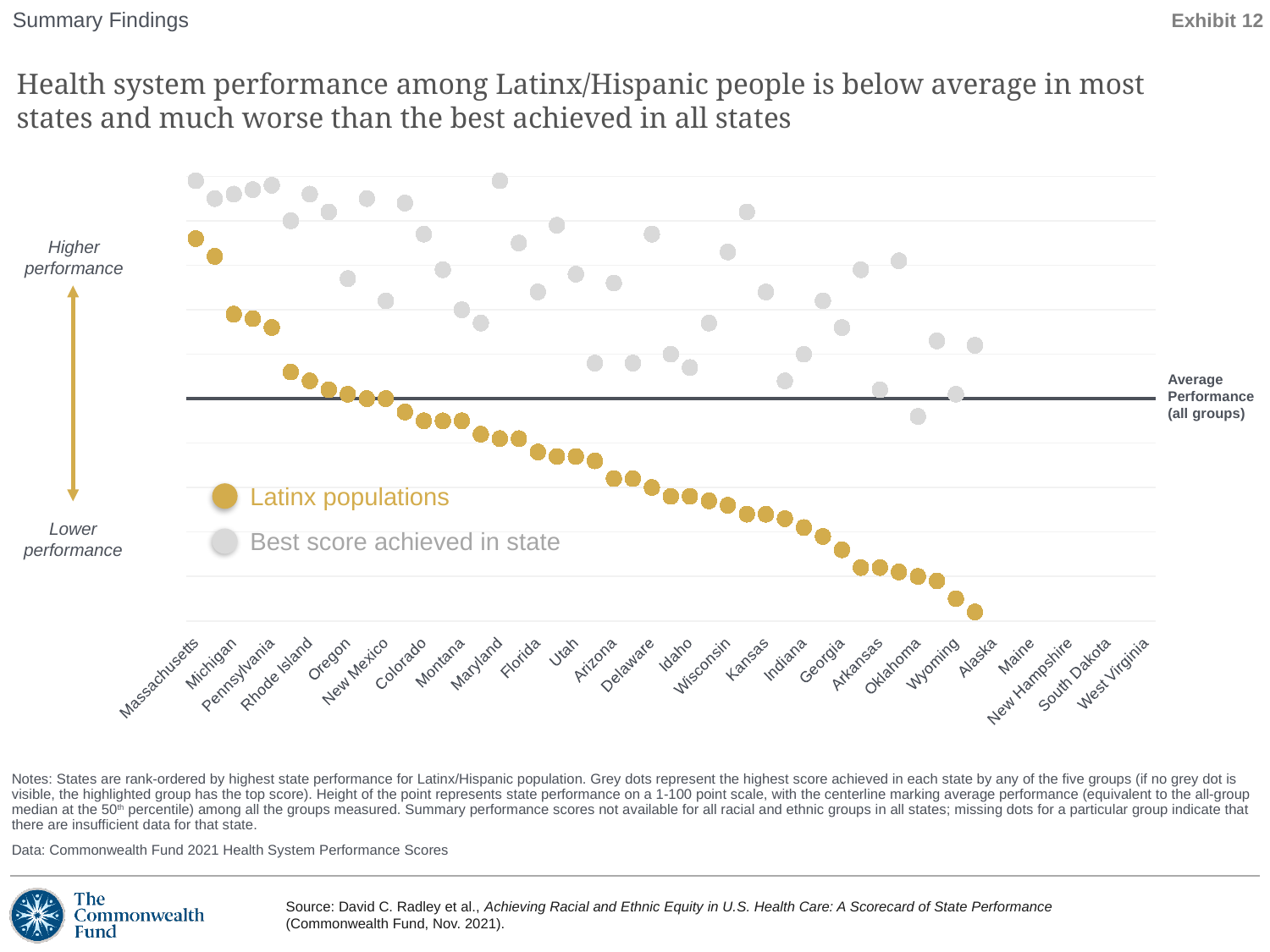
Which state has the highest Latinx population score? Massachusetts How many state names are labeled along the x axis? 26 In Massachusetts, which is higher: the Latinx population score or the best score achieved in the state? Best score achieved in state What does the horizontal centerline across the chart represent? Average Performance (all groups) Which state is labeled first (leftmost) on the x axis? Massachusetts What kind of chart is shown on the slide? Dot (scatter) chart What are the two series named in the legend? Latinx populations; Best score achieved in state Is the Latinx population score for Massachusetts above or below the average performance line? Above Do the Latinx population scores rise or fall moving from left to right along the x axis? Fall How many series does the chart's legend list? 2